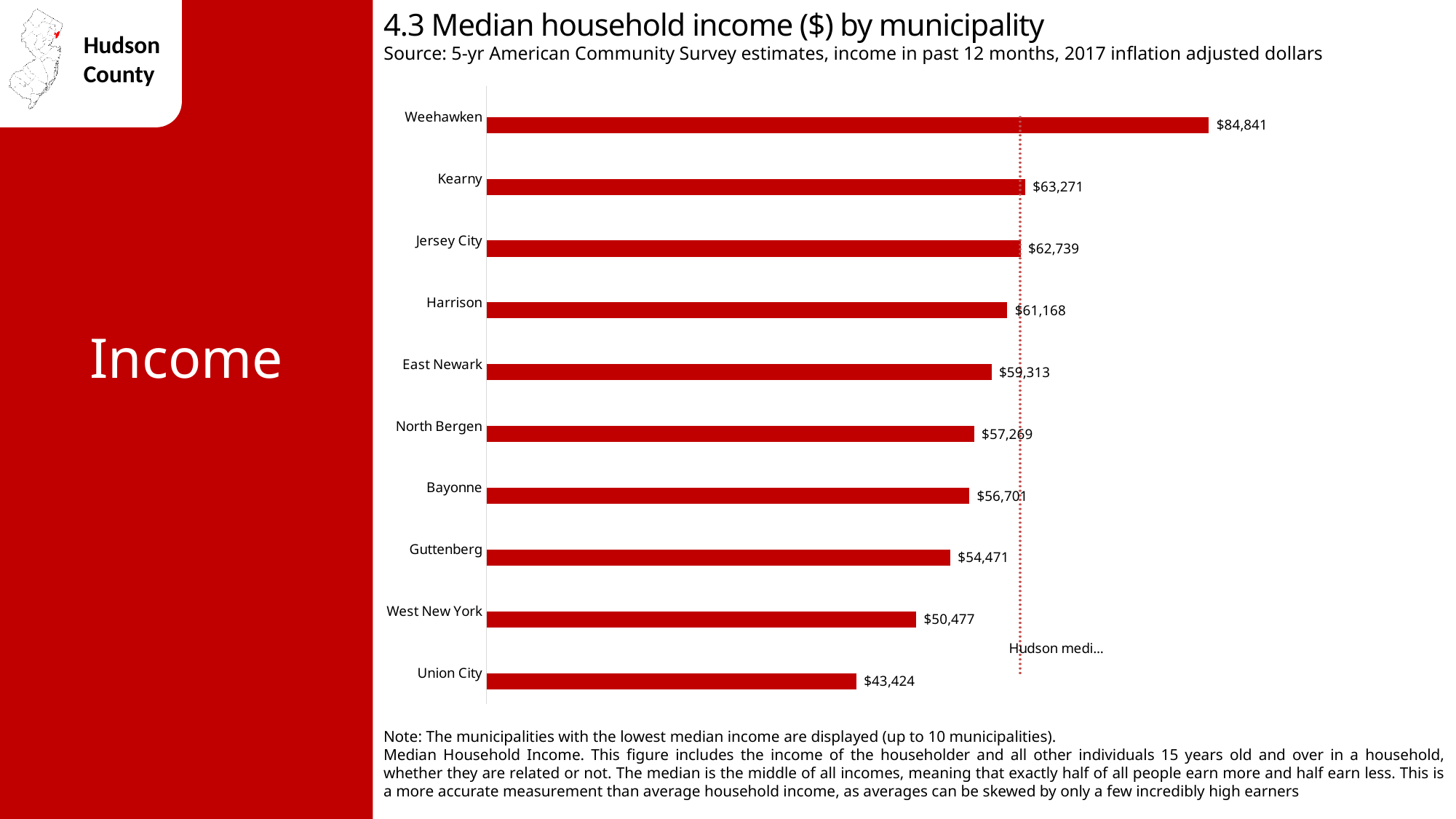
What kind of chart is shown on the slide? Bar chart What is the median household income for Union City? $43,424 Which municipality has the lowest median household income on the chart? Union City What is the difference in median household income between Kearny and Jersey City? $532 What is the difference in median household income between Weehawken and Union City? $41,417 What is the median household income for Weehawken? $84,841 Which has a higher median household income, Bayonne or West New York? Bayonne How many municipalities are shown on the chart? 10 What is the median household income for Harrison? $61,168 What is the median household income for Guttenberg? $54,471 What is the title of the chart? 4.3 Median household income ($) by municipality Which municipality has the highest median household income on the chart? Weehawken